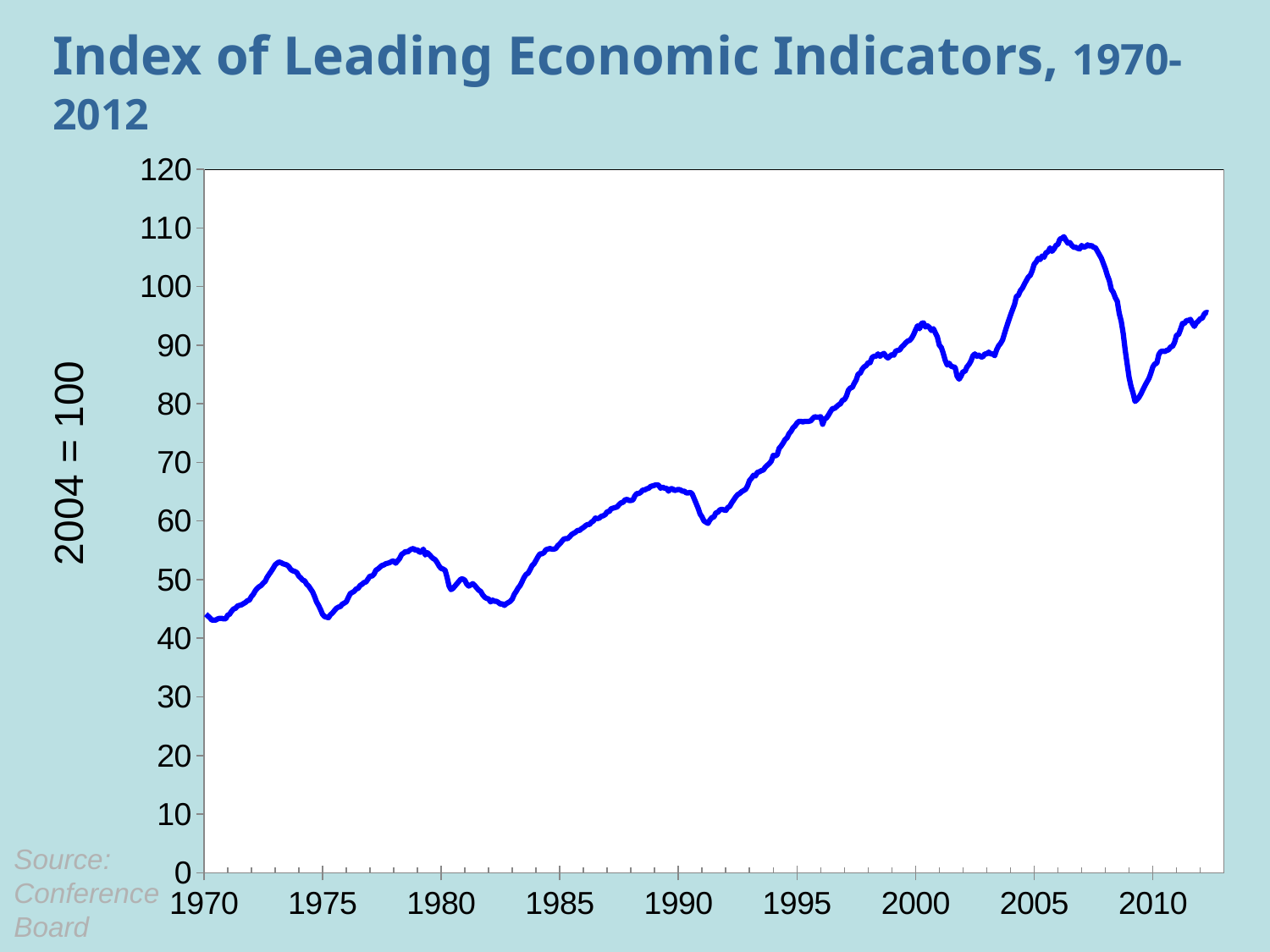
Overall, does the index rise or fall from 1970 to 2012? rise Is the peak value of the index around 2006 greater or less than 100? greater Does the index rise or fall between 2007 and 2009? fall What is the title of the chart? Index of Leading Economic Indicators, 1970-2012 Is the value of the index in 1985 greater or less than 50? greater Is the value of the index in 2000 greater or less than 80? greater Does the highest point of the line occur before or after 2000? after What kind of chart is shown on the slide? line chart What is the label on the vertical axis? 2004 = 100 Which year has the higher index value, 1995 or 2005? 2005